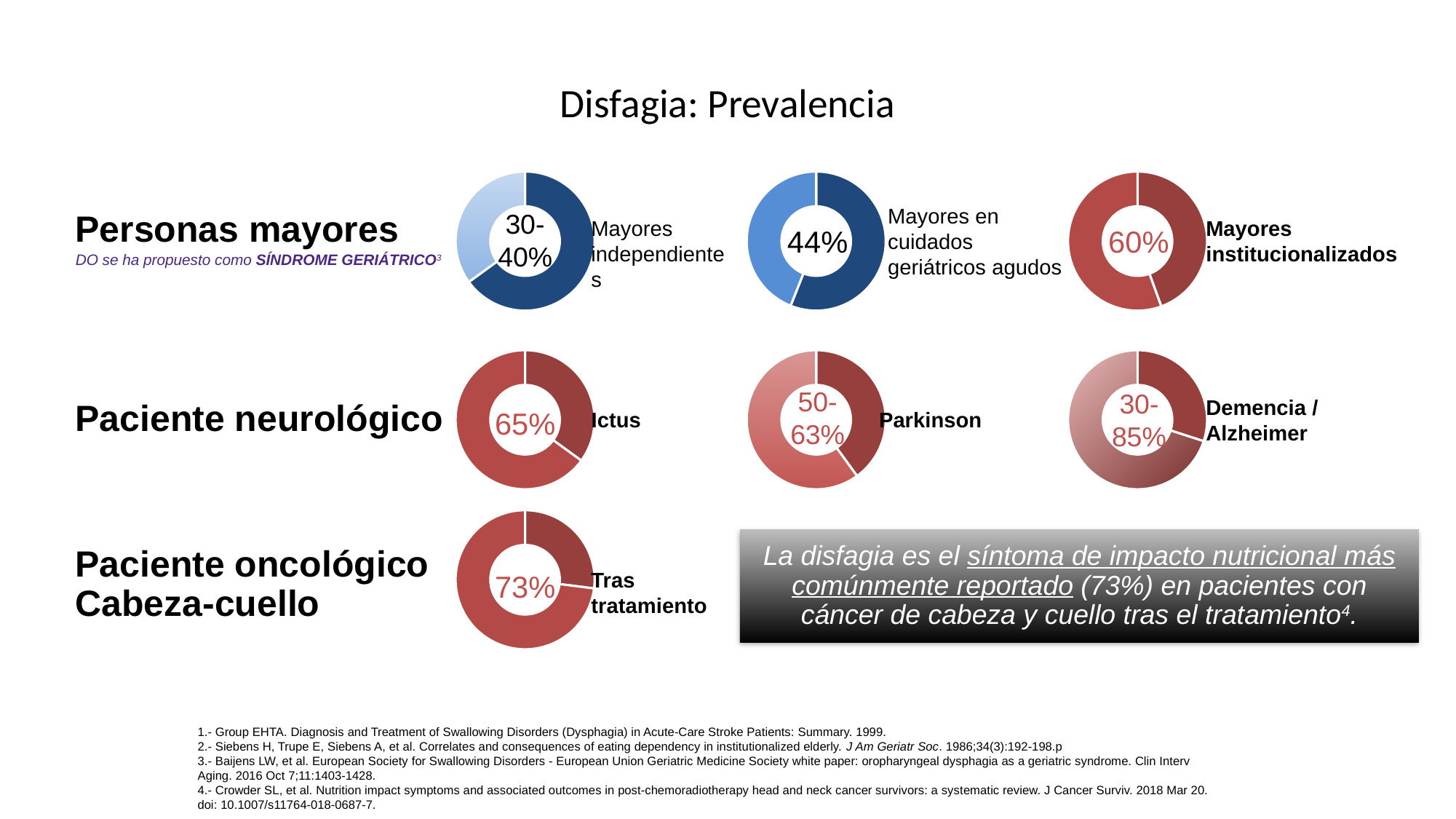
How many donut charts are shown on the slide? 7 What value is shown in the 'Parkinson' donut chart? 50-63% What value is shown in the 'Mayores en cuidados geriátricos agudos' donut chart? 44% What value is shown in the 'Demencia / Alzheimer' donut chart? 30-85% What is the difference between the value in the 'Tras tratamiento' chart and the value in the 'Ictus' chart? 8% Which donut chart in the 'Personas mayores' row is drawn in red rather than blue? Mayores institucionalizados Which is larger, the value in the 'Ictus' chart or the value in the 'Mayores institucionalizados' chart? Ictus What prevalence value is shown in the centre of the 'Mayores independientes' donut chart? 30-40% What value is shown in the 'Mayores institucionalizados' donut chart? 60% What kind of chart is used to show each prevalence value on the slide? Donut (pie) chart What value is shown in the 'Tras tratamiento' donut chart for the head and neck oncology patient? 73% What value is shown in the 'Ictus' donut chart? 65%